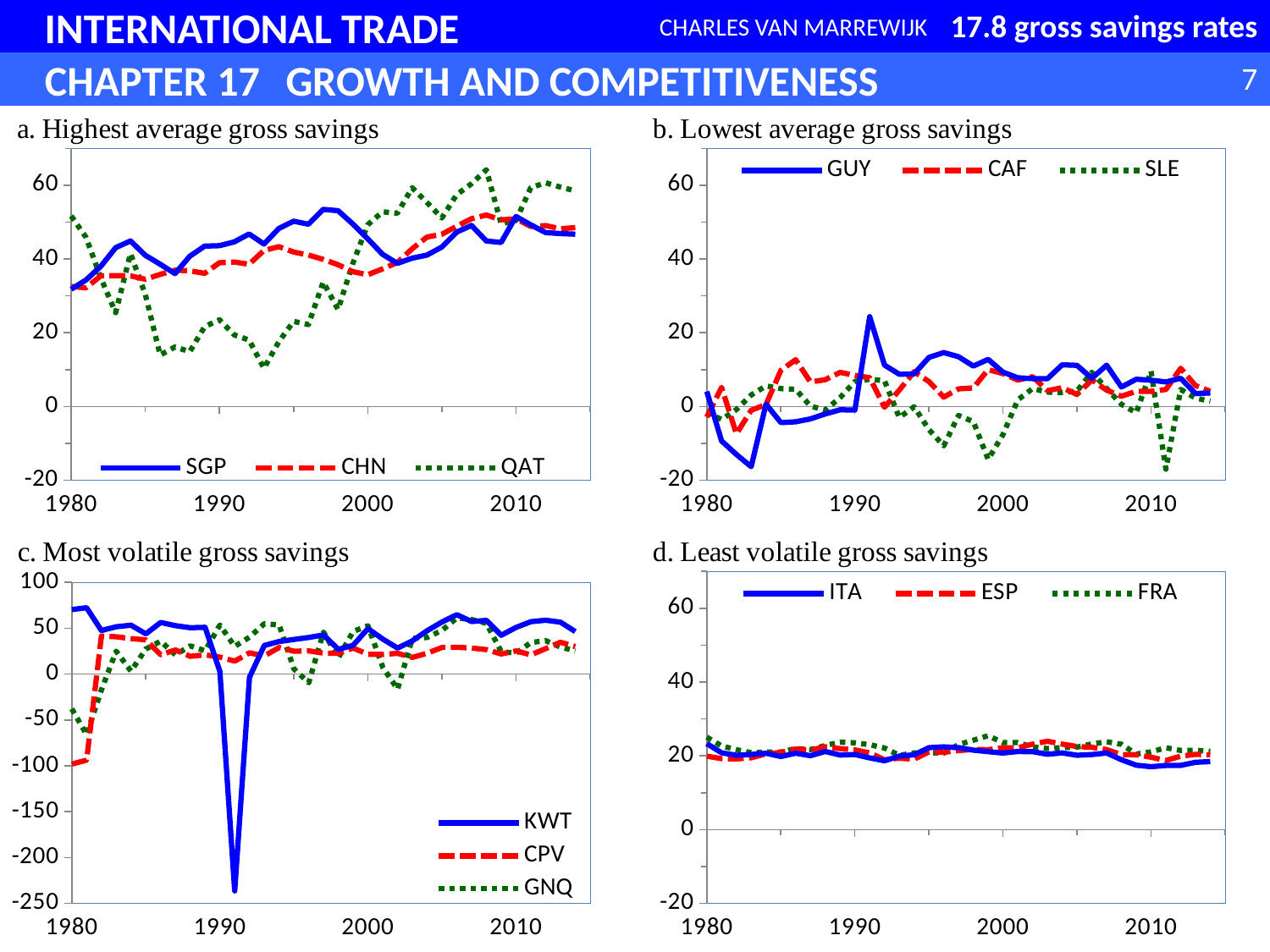
In the chart titled "a. Highest average gross savings", is the value for SGP in 1998 greater or less than 40? greater In the chart titled "c. Most volatile gross savings", which series has the larger value in 1991, KWT or CPV? CPV How many series does the legend list in the chart titled "b. Lowest average gross savings"? 3 What kind of chart is the chart titled "a. Highest average gross savings"? line chart In the chart titled "d. Least volatile gross savings", is the value for FRA in 1980 greater or less than 40? less In the chart titled "a. Highest average gross savings", does the CHN series rise or fall overall from 1980 to 2014? rise In the chart titled "c. Most volatile gross savings", is the lowest value of KWT greater or less than -200? less Which series are listed in the legend of the chart titled "d. Least volatile gross savings"? ITA, ESP, FRA In the chart titled "b. Lowest average gross savings", which series has the larger value in 1991, GUY or SLE? GUY Which series are listed in the legend of the chart titled "c. Most volatile gross savings"? KWT, CPV, GNQ